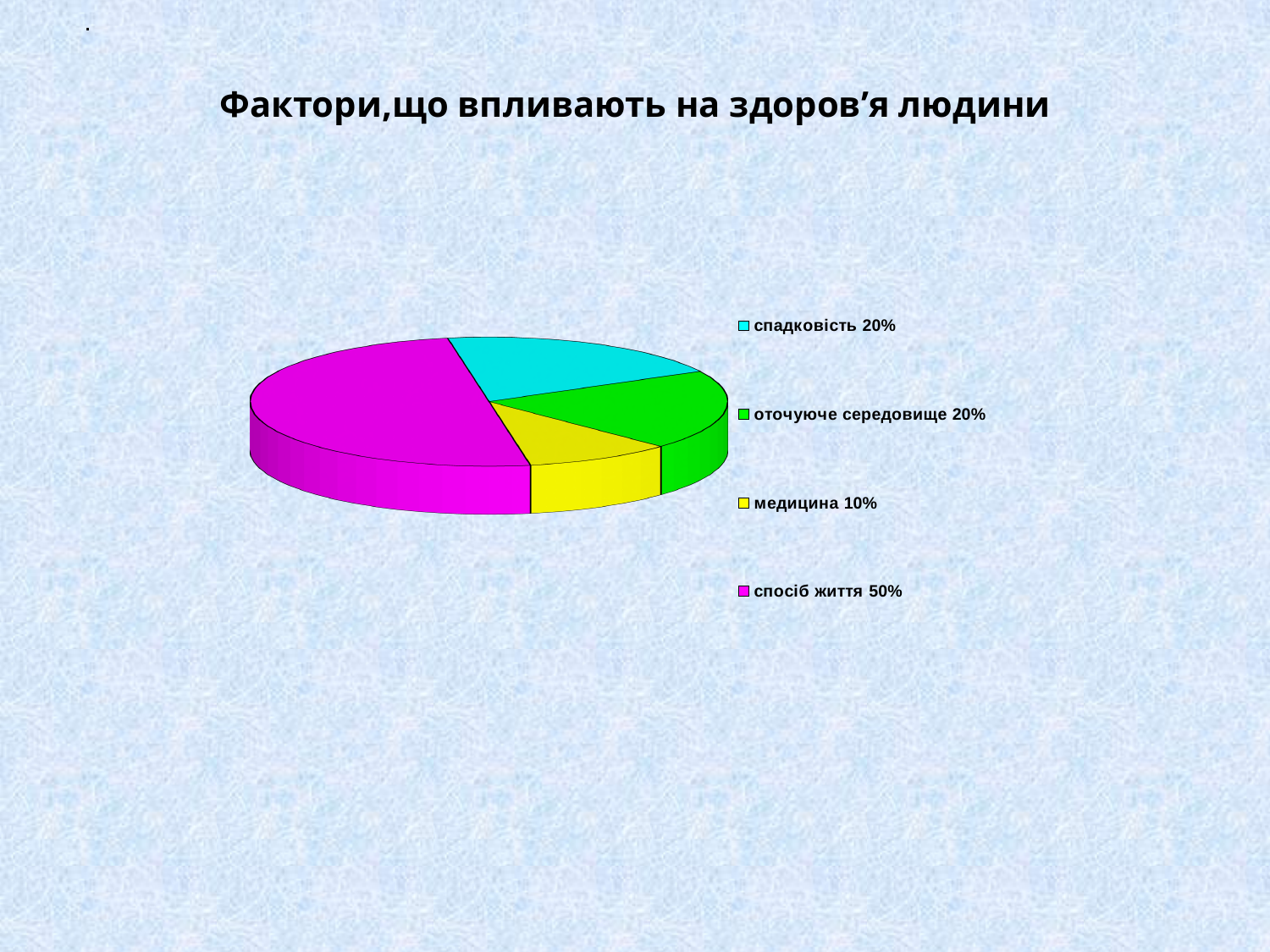
Which is larger, the share for спосіб життя or the share for спадковість? спосіб життя What is the value shown for спадковість? 20% What colour is the slice for спосіб життя? magenta What is the title of the slide above the chart? Фактори,що впливають на здоров’я людини What is the value shown for медицина? 10% What is the value shown for оточуюче середовище? 20% How many categories does the pie chart have? 4 What share of the pie does спосіб життя take? 50% Which category has the smallest share of the pie? медицина Which category has the largest share of the pie? спосіб життя What is the difference between the shares of спосіб життя and медицина? 40% What kind of chart is shown on the slide? pie chart